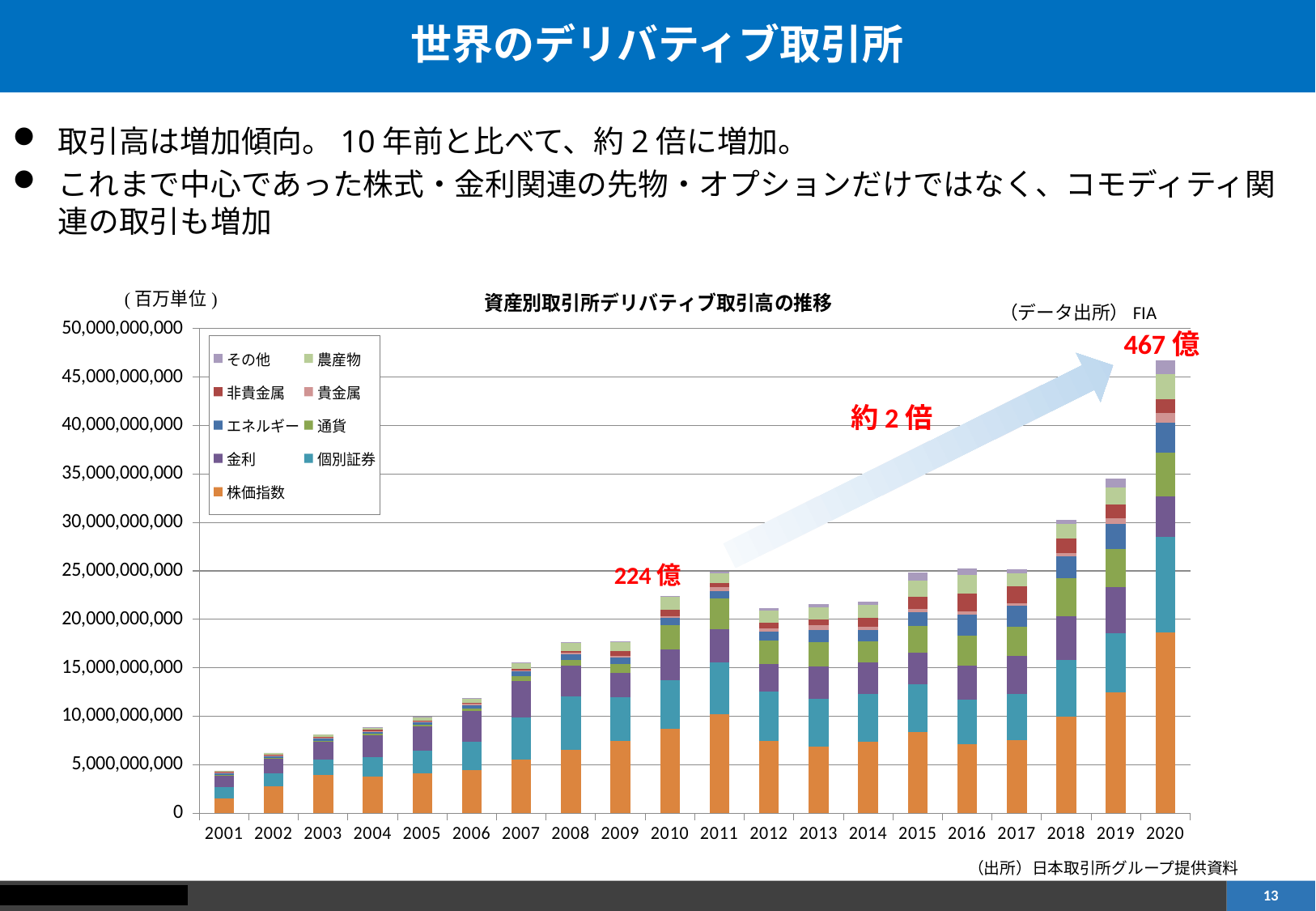
What value is annotated in red above the 2020 bar? 467 億 What value is annotated in red above the 2010 bar? 224 億 How many series does the chart legend list? 9 Which year has the lowest total trading volume in the chart? 2001 Overall, do the total bar heights rise or fall from 2001 to 2020? Rise What is the title of the chart? 資産別取引所デリバティブ取引高の推移 Which year has the larger total bar, 2011 or 2012? 2011 Is the total value for 2019 greater or less than 30,000,000,000? greater What kind of chart is shown on the slide? Stacked bar chart How many years are shown along the x axis of the chart? 20 Which year has the highest total trading volume in the chart? 2020 Is the total value for 2020 greater or less than 45,000,000,000? greater